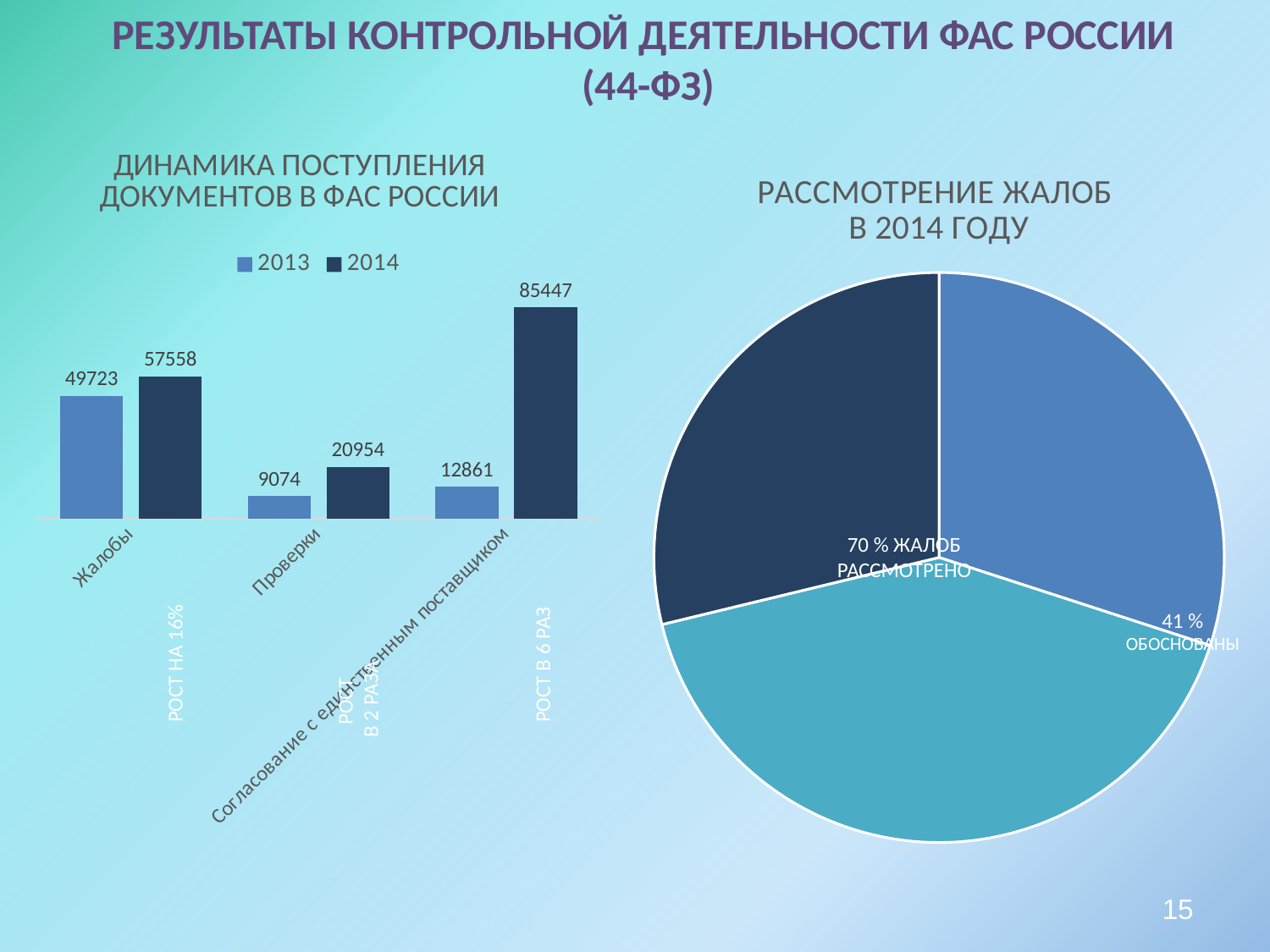
In the bar chart 'ДИНАМИКА ПОСТУПЛЕНИЯ ДОКУМЕНТОВ В ФАС РОССИИ', what is the 2014 value for Согласование с единственным поставщиком? 85447 In the bar chart 'ДИНАМИКА ПОСТУПЛЕНИЯ ДОКУМЕНТОВ В ФАС РОССИИ', which is larger: the 2013 value for Жалобы or the 2014 value for Согласование с единственным поставщиком? 2014 value for Согласование с единственным поставщиком In the bar chart 'ДИНАМИКА ПОСТУПЛЕНИЯ ДОКУМЕНТОВ В ФАС РОССИИ', what is the difference between the 2014 and 2013 values for Жалобы? 7835 How many slices does the pie chart 'РАССМОТРЕНИЕ ЖАЛОБ В 2014 ГОДУ' have? 3 How many categories are shown in the bar chart 'ДИНАМИКА ПОСТУПЛЕНИЯ ДОКУМЕНТОВ В ФАС РОССИИ'? 3 In the bar chart 'ДИНАМИКА ПОСТУПЛЕНИЯ ДОКУМЕНТОВ В ФАС РОССИИ', what is the 2014 value for Жалобы? 57558 In the bar chart 'ДИНАМИКА ПОСТУПЛЕНИЯ ДОКУМЕНТОВ В ФАС РОССИИ', what is the 2013 value for Проверки? 9074 What kind of chart is the chart titled 'РАССМОТРЕНИЕ ЖАЛОБ В 2014 ГОДУ'? Pie chart In the bar chart 'ДИНАМИКА ПОСТУПЛЕНИЯ ДОКУМЕНТОВ В ФАС РОССИИ', which category has the lowest 2013 value? Проверки In the bar chart 'ДИНАМИКА ПОСТУПЛЕНИЯ ДОКУМЕНТОВ В ФАС РОССИИ', what is the difference between the 2014 and 2013 values for Проверки? 11880 How many series does the legend of the bar chart 'ДИНАМИКА ПОСТУПЛЕНИЯ ДОКУМЕНТОВ В ФАС РОССИИ' list? 2 In the bar chart 'ДИНАМИКА ПОСТУПЛЕНИЯ ДОКУМЕНТОВ В ФАС РОССИИ', which category has the highest 2014 value? Согласование с единственным поставщиком